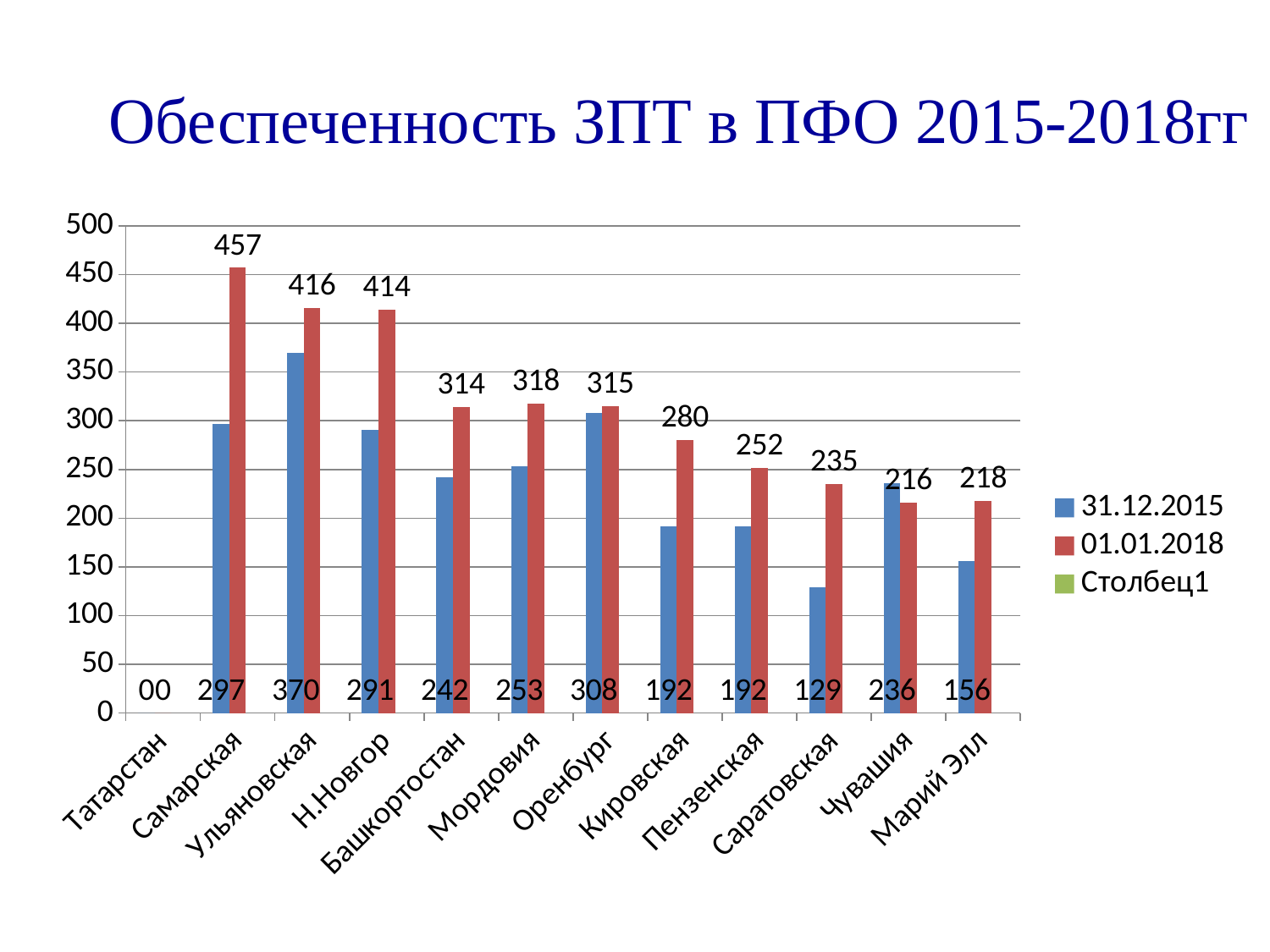
How many series does the legend list? 3 Which is larger for Чувашия: the 31.12.2015 value or the 01.01.2018 value? 31.12.2015 Which category has the lowest value in the 31.12.2015 series? Татарстан What is the value for Саратовская in the 31.12.2015 series? 129 What type of chart is shown on the slide? bar chart How many categories are shown on the x axis? 12 What is the value for Самарская in the 01.01.2018 series? 457 What is the difference between the 01.01.2018 and 31.12.2015 values for Кировская? 88 What is the title of the chart? Обеспеченность ЗПТ в ПФО 2015-2018гг What is the value for Ульяновская in the 31.12.2015 series? 370 Is the 01.01.2018 value for Н.Новгор greater or less than 400? greater Which category has the highest value in the 01.01.2018 series? Самарская